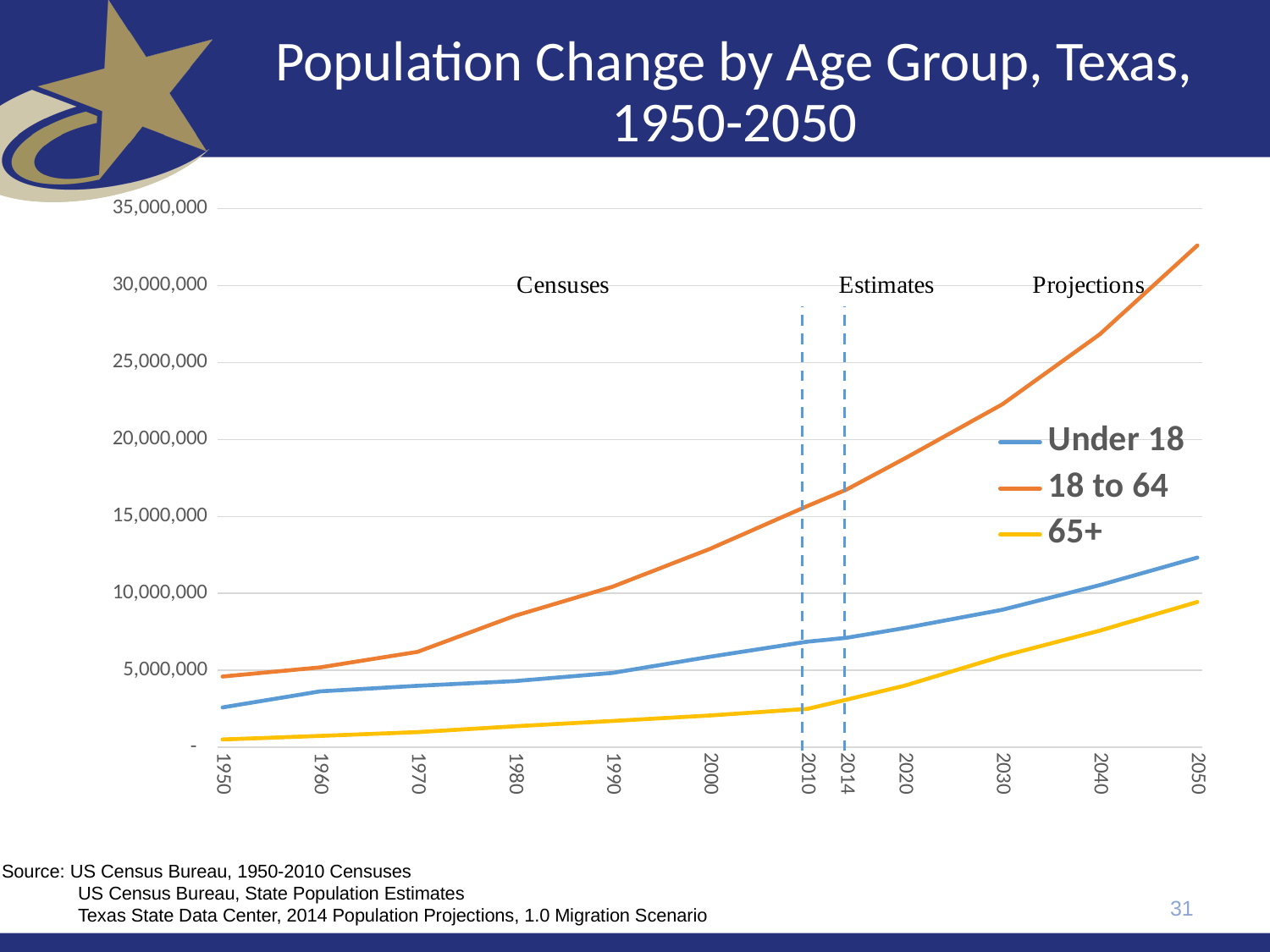
Is the value for 65+ in 2050 greater or less than 10,000,000? less Is the value for 18 to 64 in 2030 greater or less than 20,000,000? greater What is the title of the chart? Population Change by Age Group, Texas, 1950-2050 How many series does the legend list? 3 In 2050, which is larger: the Under 18 population or the 65+ population? Under 18 Does the 18 to 64 population rise or fall from 1950 to 2050? rise What kind of chart is shown on the slide? line chart Which age group has the highest population in 2050? 18 to 64 How many years are labelled along the x axis? 12 Is the value for 18 to 64 in 2050 greater or less than 30,000,000? greater Which age group has the lowest population in 2050? 65+